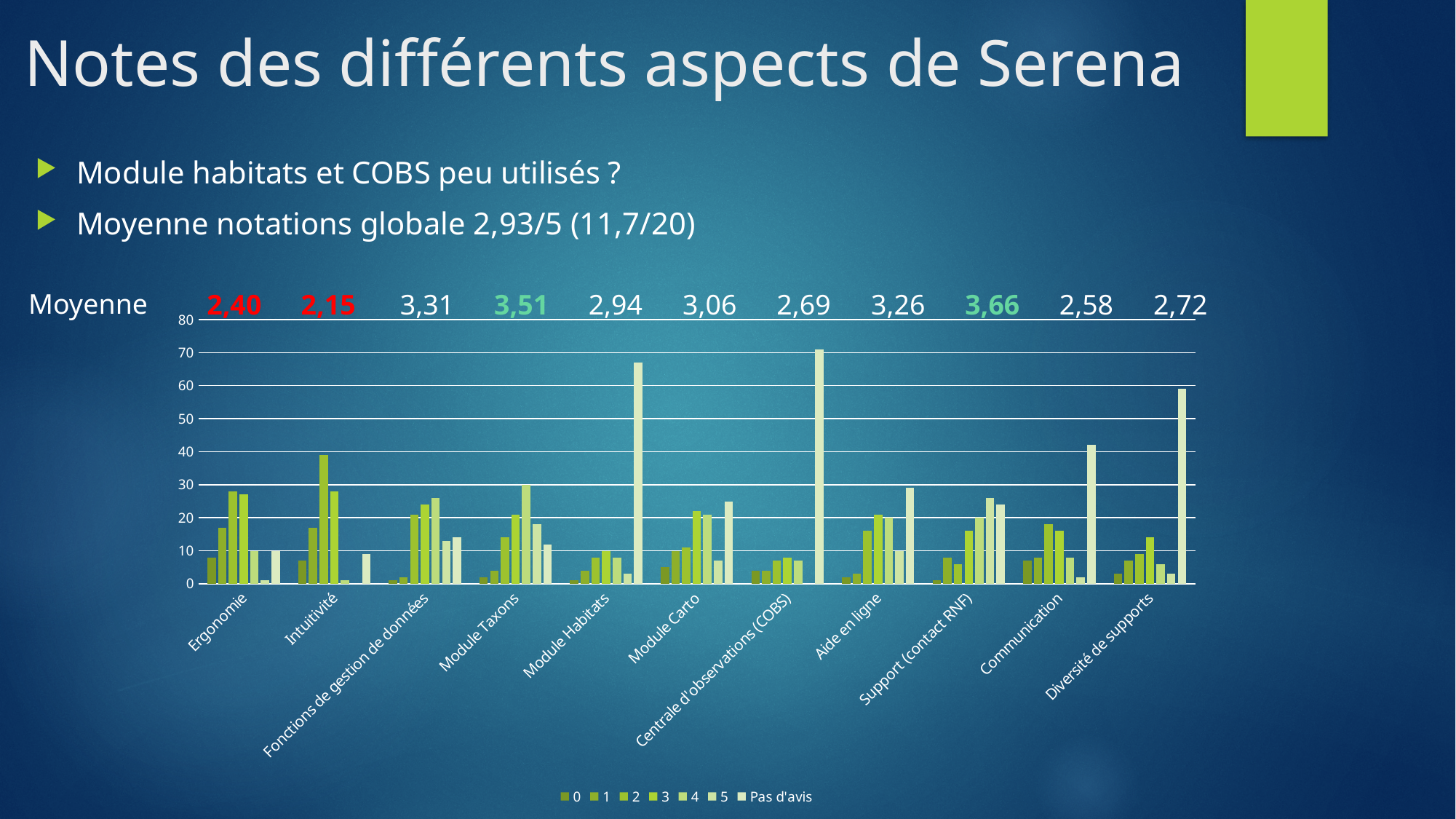
How many series does the chart legend list? 7 What is the difference between the Moyenne values for Support (contact RNF) and Intuitivité? 1,51 Which category has the lowest Moyenne value shown above the chart? Intuitivité What kind of chart is shown on the slide? bar chart How many categories are shown along the x axis of the chart? 11 Is the value of the series 2 bar for Intuitivité greater or less than 30? greater Which category has the highest Moyenne value shown above the chart? Support (contact RNF) What is the Moyenne value shown above the chart for Module Taxons? 3,51 What is the Moyenne value shown above the chart for Ergonomie? 2,40 Is the value of the Pas d'avis bar for Module Habitats greater or less than 60? greater What is the last entry in the chart legend? Pas d'avis Which has the higher Moyenne value, Module Taxons or Module Carto? Module Taxons